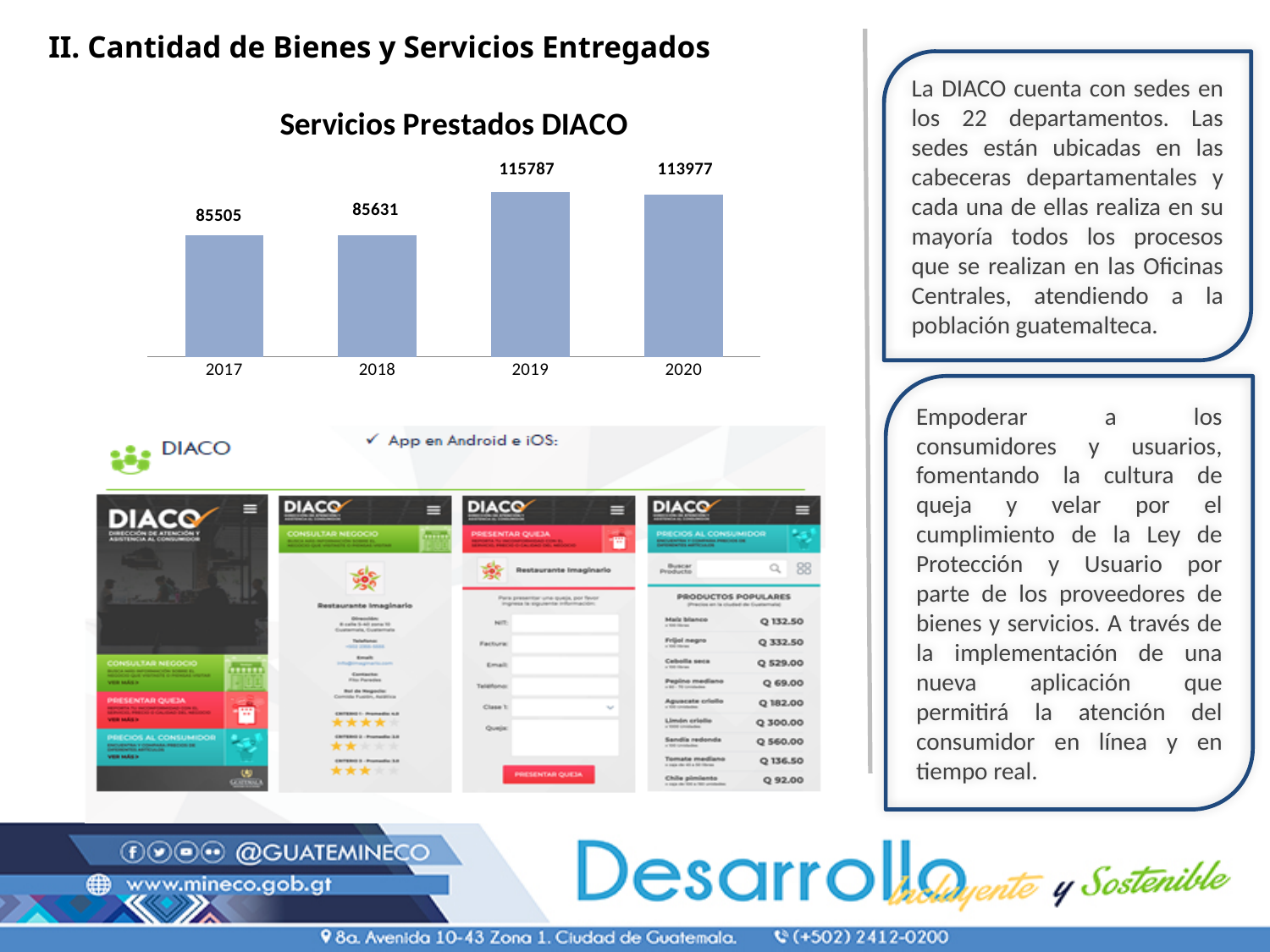
Which year has the lowest value in the Servicios Prestados DIACO chart? 2017 Do the values in the Servicios Prestados DIACO chart rise or fall from 2018 to 2019? rise Which is larger in the Servicios Prestados DIACO chart, the value for 2019 or the value for 2020? 2019 What is the difference between the values for 2018 and 2017 in the Servicios Prestados DIACO chart? 126 How many years are shown in the Servicios Prestados DIACO chart? 4 What is the value for 2019 in the Servicios Prestados DIACO chart? 115787 What is the value for 2020 in the Servicios Prestados DIACO chart? 113977 What is the difference between the values for 2019 and 2020 in the Servicios Prestados DIACO chart? 1810 What is the value for 2017 in the Servicios Prestados DIACO chart? 85505 What kind of chart is the Servicios Prestados DIACO chart? bar chart What is the title of the chart on the slide? Servicios Prestados DIACO Which year has the highest value in the Servicios Prestados DIACO chart? 2019